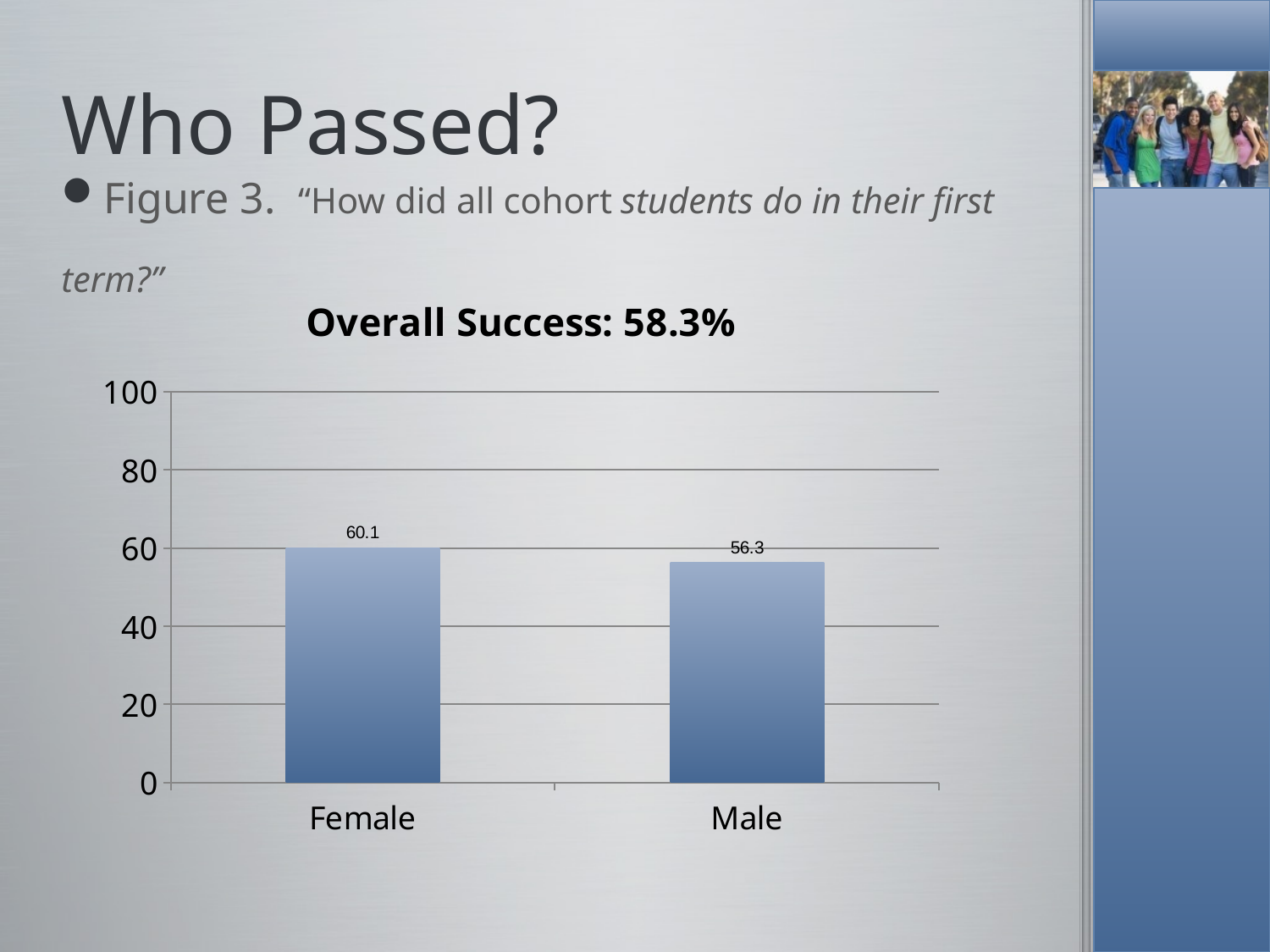
What is the highest tick value shown on the y axis? 100 What kind of chart is shown on the slide? bar chart What is the difference between the Female and Male values? 3.8 Which is larger, the value for Female or the value for Male? Female What is the value for Male? 56.3 Which category has the lowest value? Male How many categories are shown on the x axis? 2 Is the value for Male greater or less than 60? less What is the value for Female? 60.1 Is the value for Female greater or less than 40? greater Which category has the highest value? Female What overall success rate is stated above the chart? 58.3%